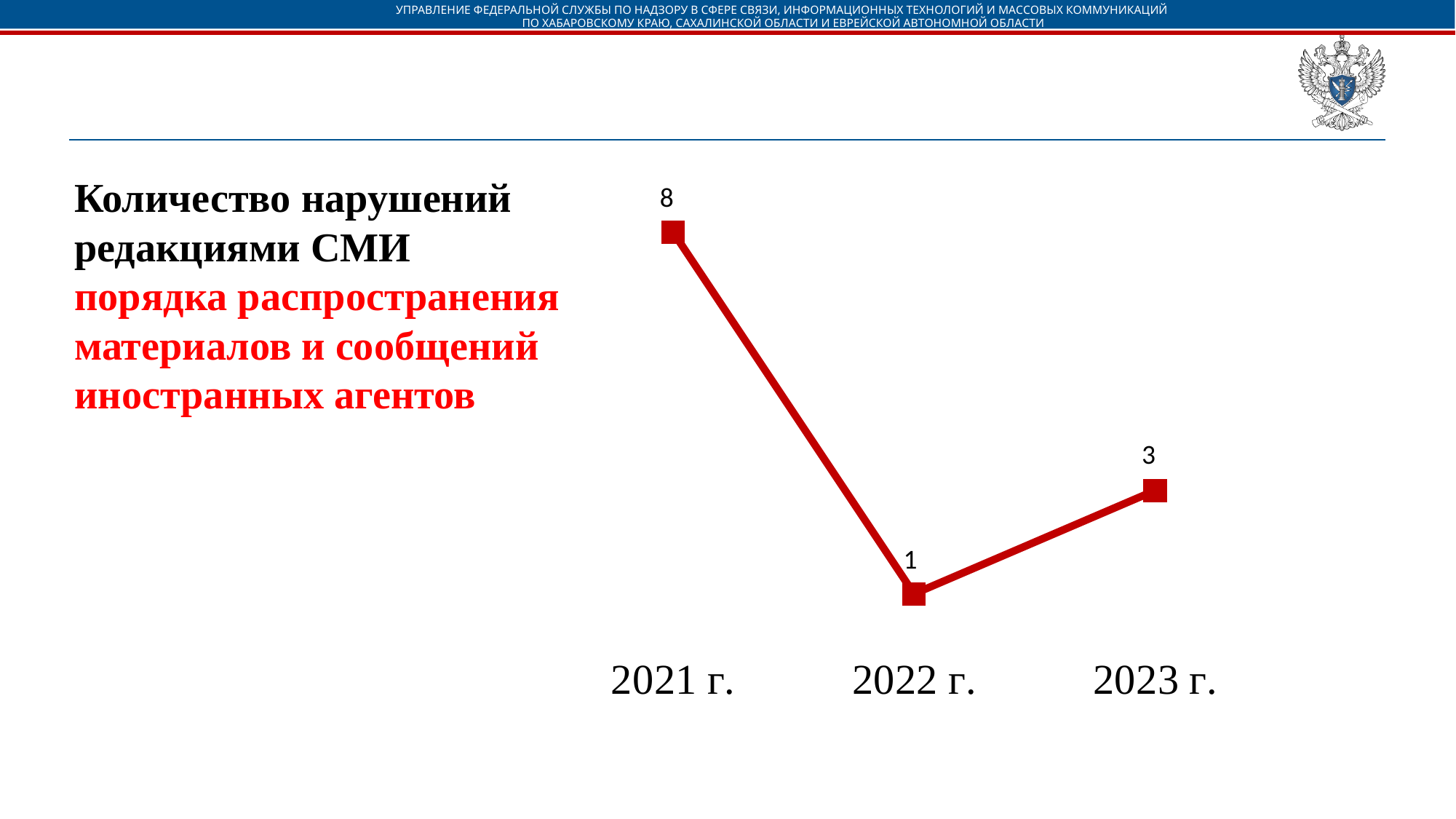
What is the value for 2023 г.? 3 Does the value rise or fall from 2021 г. to 2022 г.? fall What is the value for 2022 г.? 1 What is the value for 2021 г.? 8 What is the difference between the values for 2023 г. and 2022 г.? 2 Which year has the lowest value? 2022 г. What colour is the line on the chart? red What kind of chart is shown on the slide? line chart Which is larger, the value for 2021 г. or the value for 2023 г.? 2021 г. How many data points are plotted on the chart? 3 Which year has the highest value? 2021 г. What is the difference between the values for 2021 г. and 2022 г.? 7